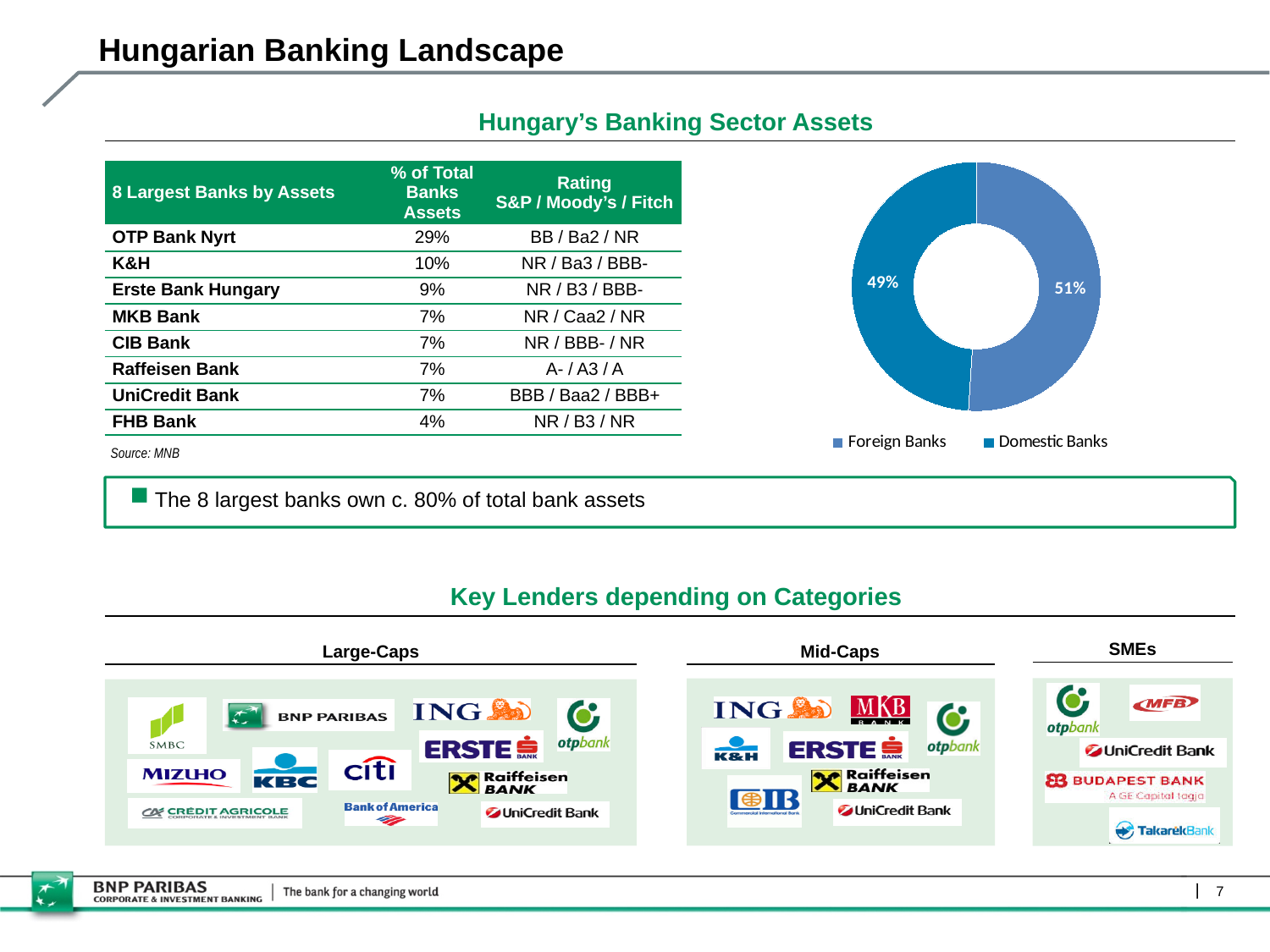
Which category has the smaller slice in the donut chart? Domestic Banks How many categories does the legend of the donut chart list? 2 What is the title above the donut chart? Hungary's Banking Sector Assets What is the difference in percentage points between the two slices of the donut chart? 2 percentage points What share of the donut chart is labelled for Foreign Banks? 51% Is the Foreign Banks slice larger or smaller than the Domestic Banks slice? Larger What do the two slices of the donut chart add up to? 100% Is the Domestic Banks share in the donut chart greater or less than 50%? less Which category has the larger slice in the donut chart? Foreign Banks What share of the donut chart is labelled for Domestic Banks? 49% What are the two categories shown in the donut chart's legend? Foreign Banks and Domestic Banks What kind of chart is shown under the heading "Hungary's Banking Sector Assets"? Pie chart (donut)